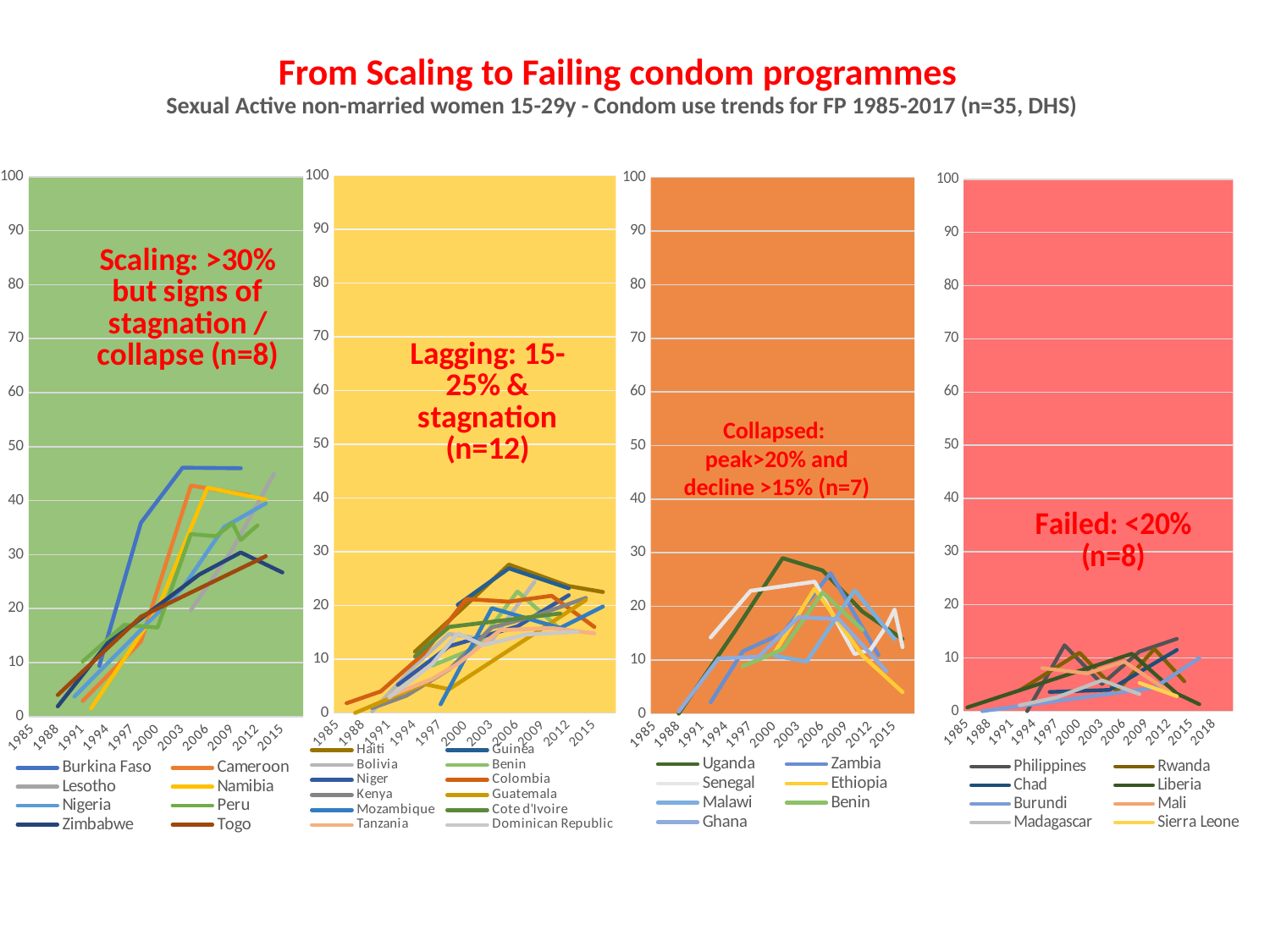
How many series does the legend of the Lagging chart list? 12 In the Failed chart, is the highest value reached by any line greater or less than 20? less In the Collapsed chart, is the peak value for Uganda greater or less than 20? greater What kind of chart is the leftmost chart (Scaling)? Line chart How many series does the legend of the Collapsed chart list? 7 In the Scaling chart, is the peak value for Burkina Faso greater or less than 40? greater In the Collapsed chart, does the Uganda line rise or fall between 2003 and 2015? fall In the Scaling chart, does the Burkina Faso line rise or fall between 1991 and 2003? rise What is the maximum value shown on the y axis of each chart? 100 How many series does the legend of the Failed chart list? 8